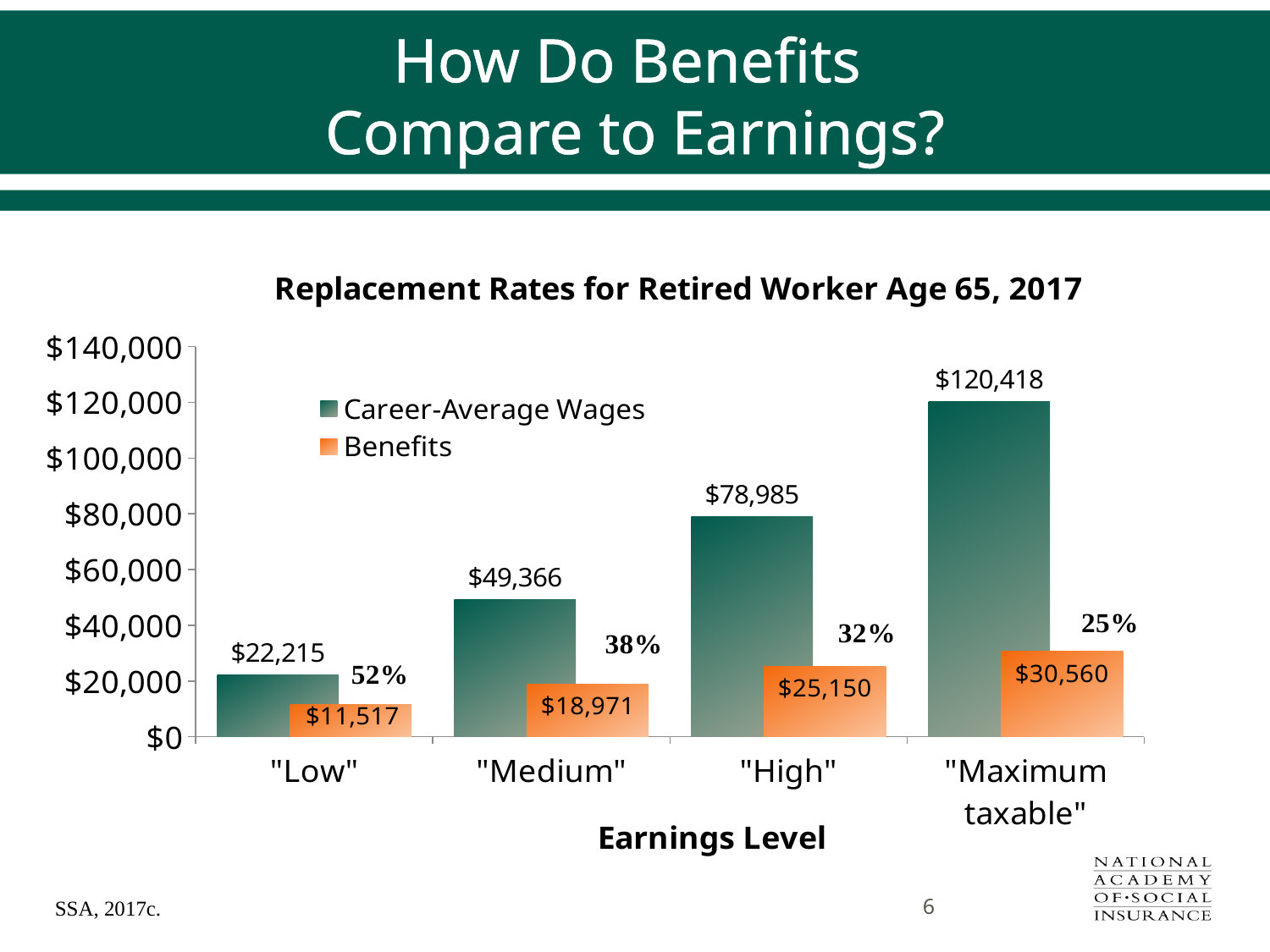
How many series does the legend list? 2 What kind of chart is shown on the slide? Bar chart What is the Benefits value for the "Maximum taxable" earnings level? $30,560 Which earnings level has the highest Career-Average Wages? "Maximum taxable" Which earnings level has the lowest Benefits value? "Low" What is the Career-Average Wages value for the "Medium" earnings level? $49,366 How many earnings levels are shown on the x axis? 4 What is the chart's title? Replacement Rates for Retired Worker Age 65, 2017 What is the difference between Career-Average Wages and Benefits for the "Low" earnings level? $10,698 What is the Benefits value for the "High" earnings level? $25,150 Is the Career-Average Wages value for "High" greater or less than $60,000? greater Which is larger: Benefits for "Medium" or Benefits for "High"? Benefits for "High"